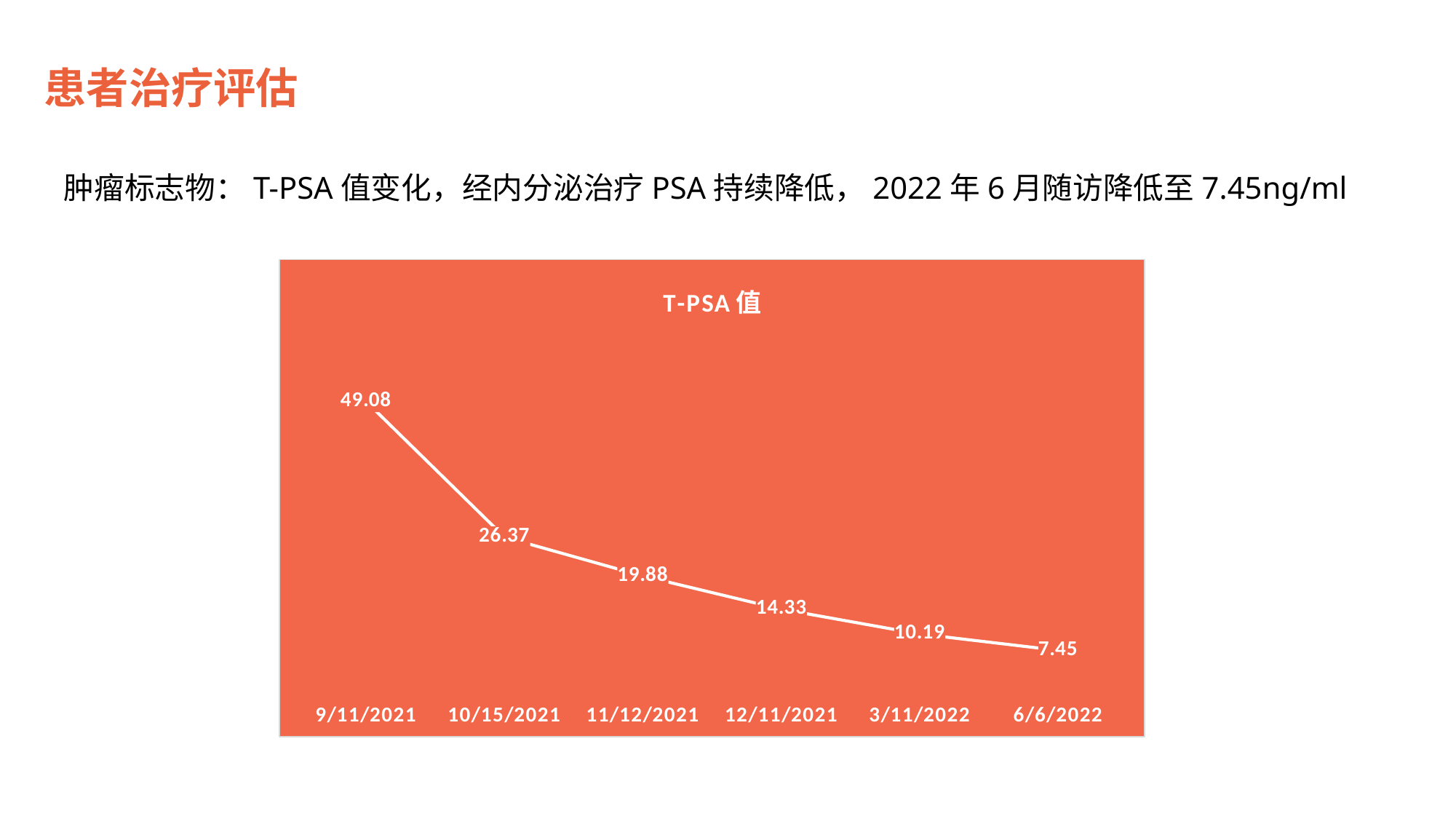
How many data points are plotted in the chart? 6 What is the T-PSA value on 6/6/2022? 7.45 What is the title of the chart? T-PSA 值 On which date is the T-PSA value lowest? 6/6/2022 On which date is the T-PSA value highest? 9/11/2021 What is the difference between the T-PSA values on 9/11/2021 and 10/15/2021? 22.71 Do the T-PSA values rise or fall over time along the x axis? fall What is the T-PSA value on 12/11/2021? 14.33 What kind of chart is shown on the slide? line chart What is the difference between the T-PSA values on 11/12/2021 and 3/11/2022? 9.69 What is the T-PSA value on 9/11/2021? 49.08 Which is larger, the T-PSA value on 10/15/2021 or on 12/11/2021? 10/15/2021